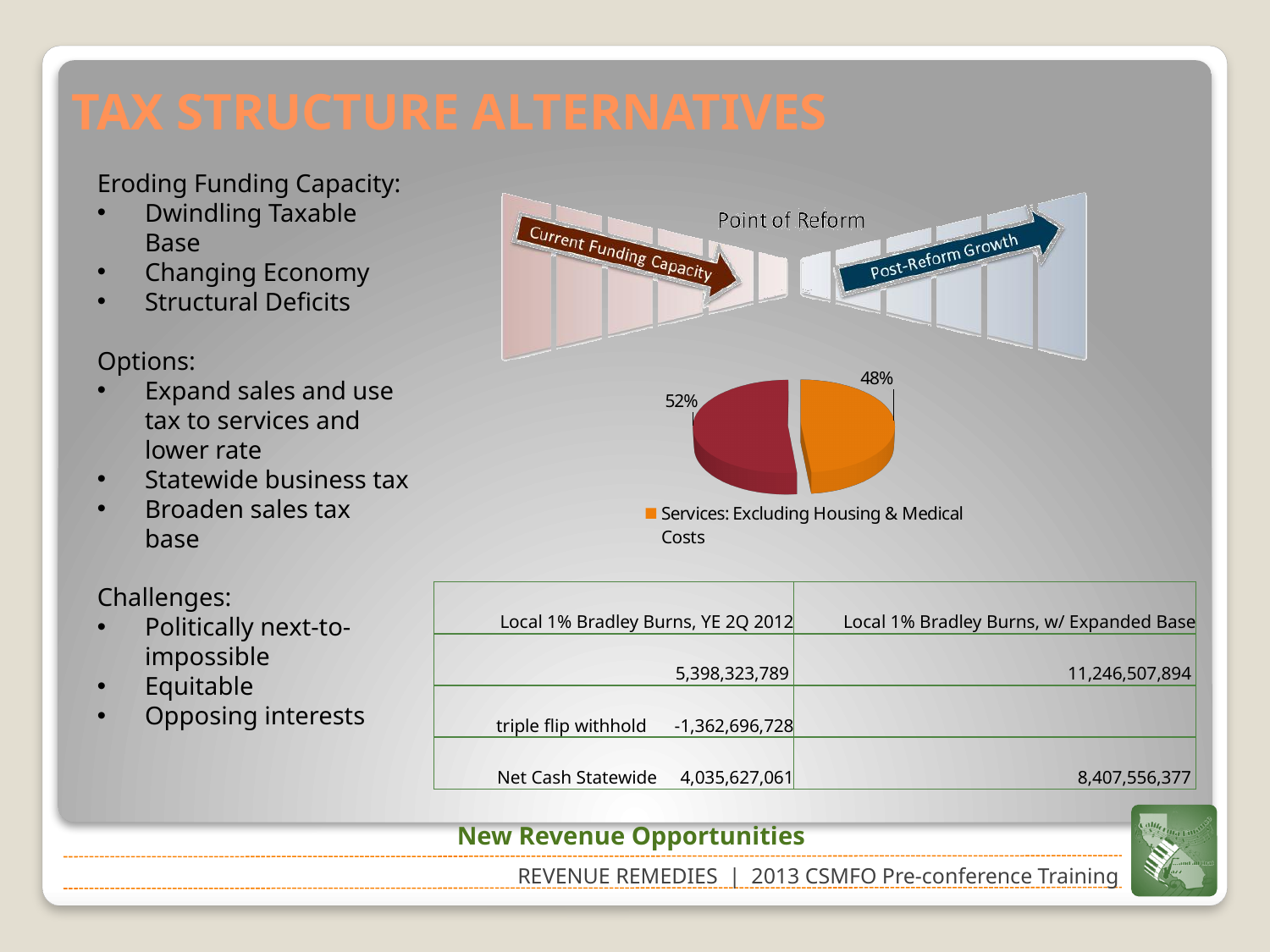
Is the Services: Excluding Housing & Medical Costs slice larger or smaller than the other slice of the pie chart? smaller Is the share for Services: Excluding Housing & Medical Costs greater or less than 50%? less How many entries does the pie chart's legend list? 1 What is the difference in percentage points between the two slices of the pie chart? 4% What percentage does the pie chart show for Services: Excluding Housing & Medical Costs? 48% What kind of chart is shown on the slide? pie chart What is the only entry listed in the pie chart's legend? Services: Excluding Housing & Medical Costs What is the largest percentage shown on the pie chart? 52% What is the smallest percentage shown on the pie chart? 48% What colour is the Services: Excluding Housing & Medical Costs slice in the pie chart? orange How many slices does the pie chart have? 2